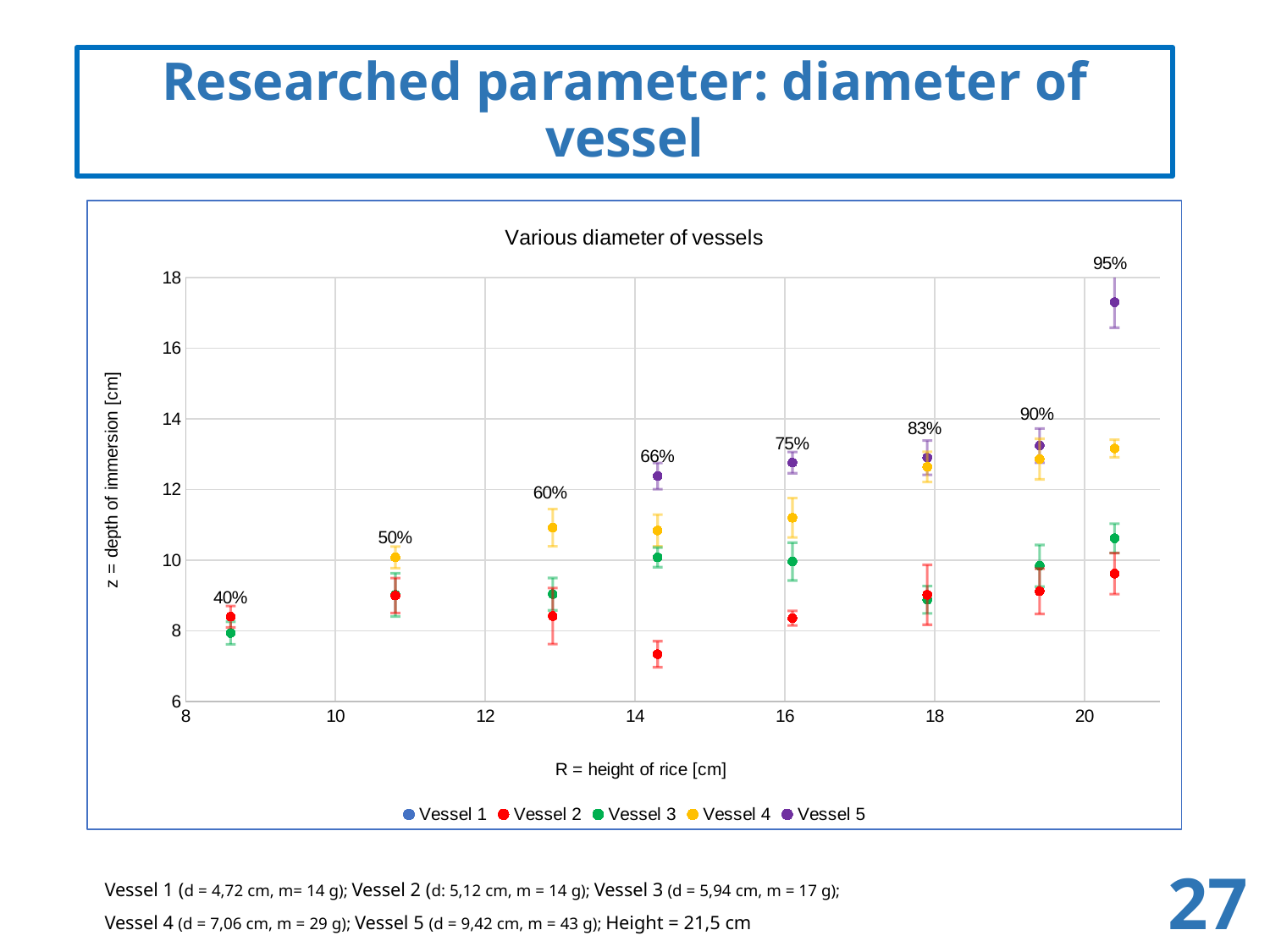
Do the values for Vessel 5 rise or fall as the height of rice increases? rise What percentage label is shown above the leftmost group of points? 40% What is the label of the x axis? R = height of rice [cm] Is the value for Vessel 5 at the rightmost x position greater or less than 16? greater Is the lowest value for Vessel 2 greater or less than 8? less How many percentage labels are printed on the chart? 8 What percentage label is shown above the rightmost group of points? 95% Which series has the highest plotted point on the chart? Vessel 5 Which series has the lowest plotted point on the chart? Vessel 2 How many series does the legend list? 5 What kind of chart is shown on the slide? scatter chart What is the title of the chart? Various diameter of vessels